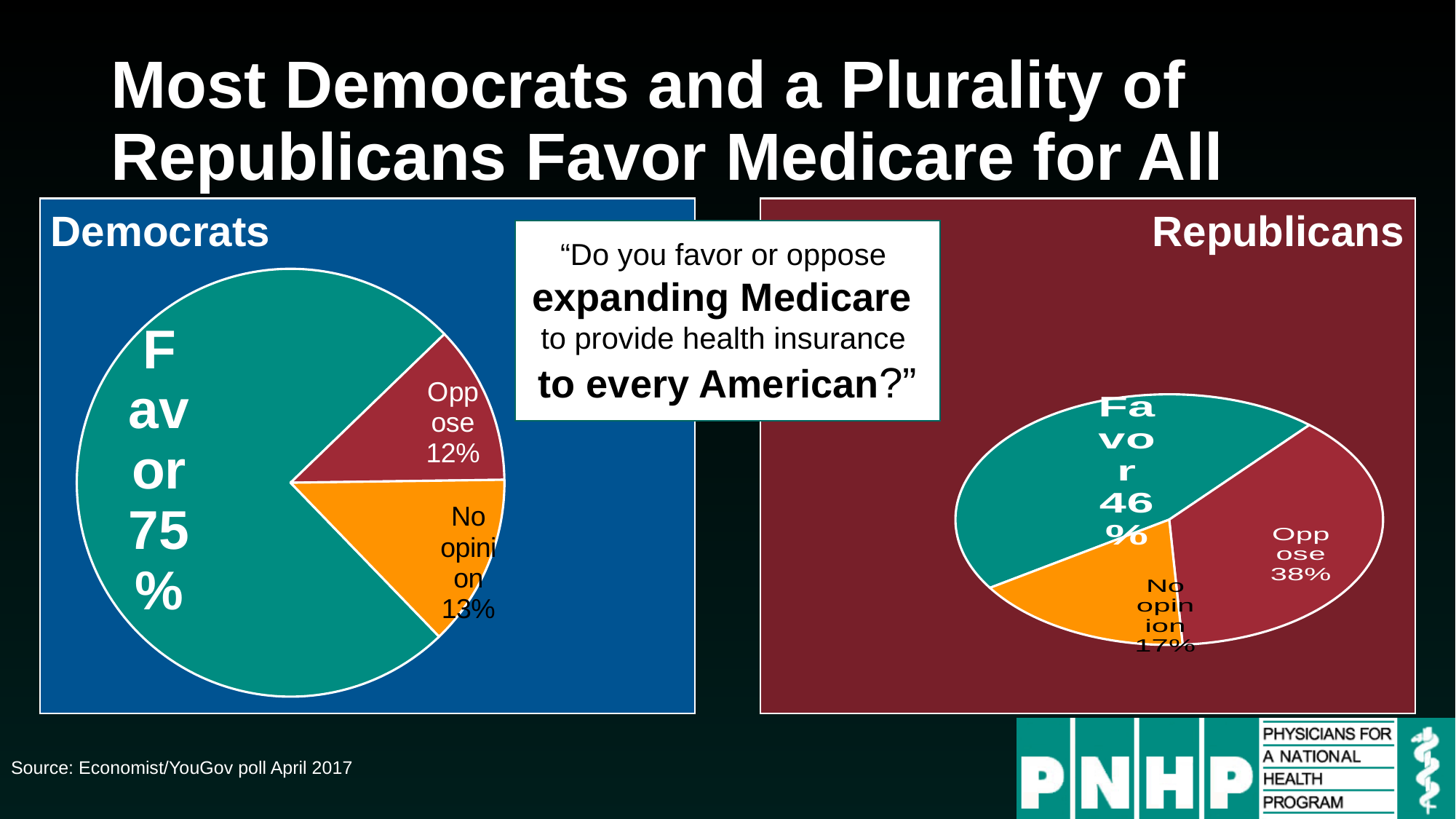
In the Democrats chart, which slice is the smallest? Oppose In the Republicans chart, what share of respondents favor? 46% In the Democrats chart, what percentage oppose? 12% What is the difference between the Favor share in the Democrats chart and the Favor share in the Republicans chart? 29 percentage points Which is larger: the Oppose share in the Republicans chart or the Oppose share in the Democrats chart? Republicans In the Republicans chart, which slice is the largest? Favor What type of chart is used for the Republicans data? Pie chart In the Republicans chart, what percentage have no opinion? 17% How many slices does the Democrats pie chart have? 3 In the Democrats chart, what percentage have no opinion? 13% In the Republicans chart, what percentage oppose? 38% In the Democrats chart, what share of respondents favor expanding Medicare? 75%